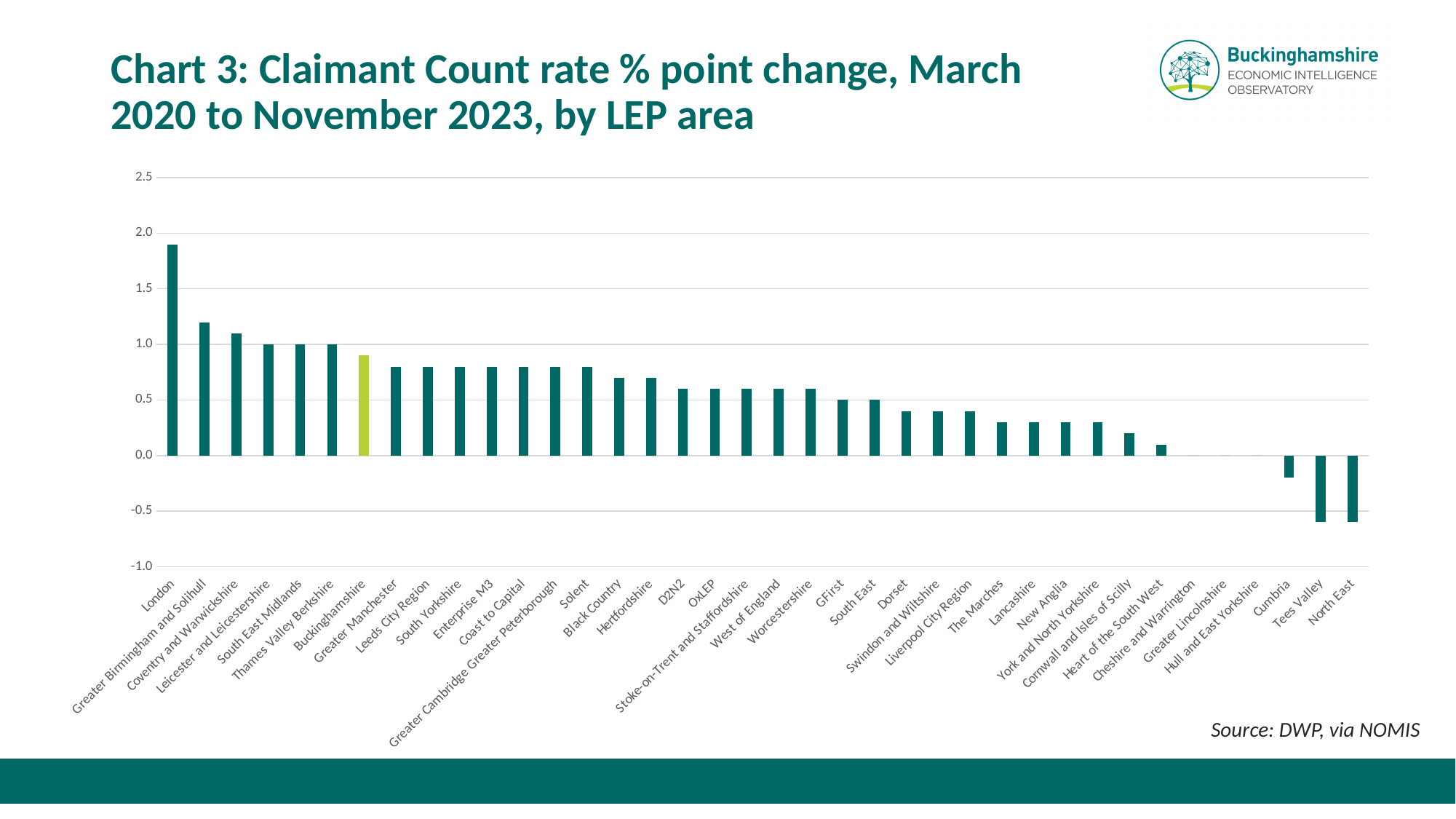
Which LEP area's bar is highlighted in a different (light green) colour from the others? Buckinghamshire Which is larger, the value for Buckinghamshire or the value for Dorset? Buckinghamshire Is the value for Cumbria greater or less than -0.5? greater Is the value for Buckinghamshire greater or less than 1.0? less Which LEP area has the highest claimant count rate % point change? London Is the value for Tees Valley greater or less than -0.5? less What kind of chart is shown on the slide? Bar chart Which is larger, the value for London or the value for Coventry and Warwickshire? London Do the values generally rise or fall moving from left to right along the x axis? Fall How many LEP areas are shown on the x axis? 38